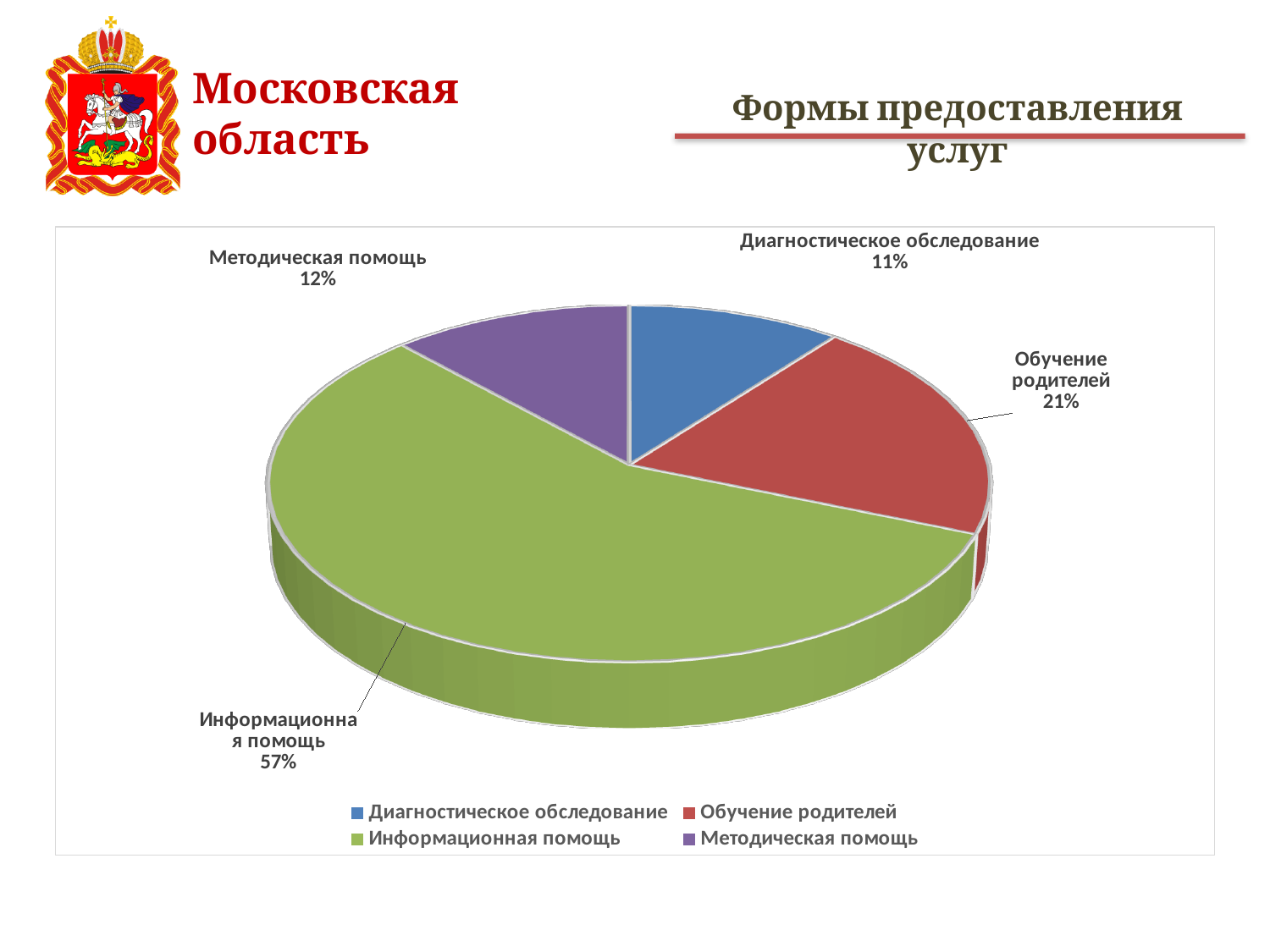
What share of the pie does Диагностическое обследование have? 11% Which category has the largest share of the pie? Информационная помощь What share of the pie does Обучение родителей have? 21% What colour is the slice for Методическая помощь? Purple How many categories are shown in the pie chart? 4 What is the difference in percentage points between Информационная помощь and Обучение родителей? 36 What share of the pie does Методическая помощь have? 12% What kind of chart is shown on the slide? Pie chart Which category has the smallest share of the pie? Диагностическое обследование Which is larger, the share for Обучение родителей or the share for Методическая помощь? Обучение родителей What is the title of the chart on the slide? Формы предоставления услуг